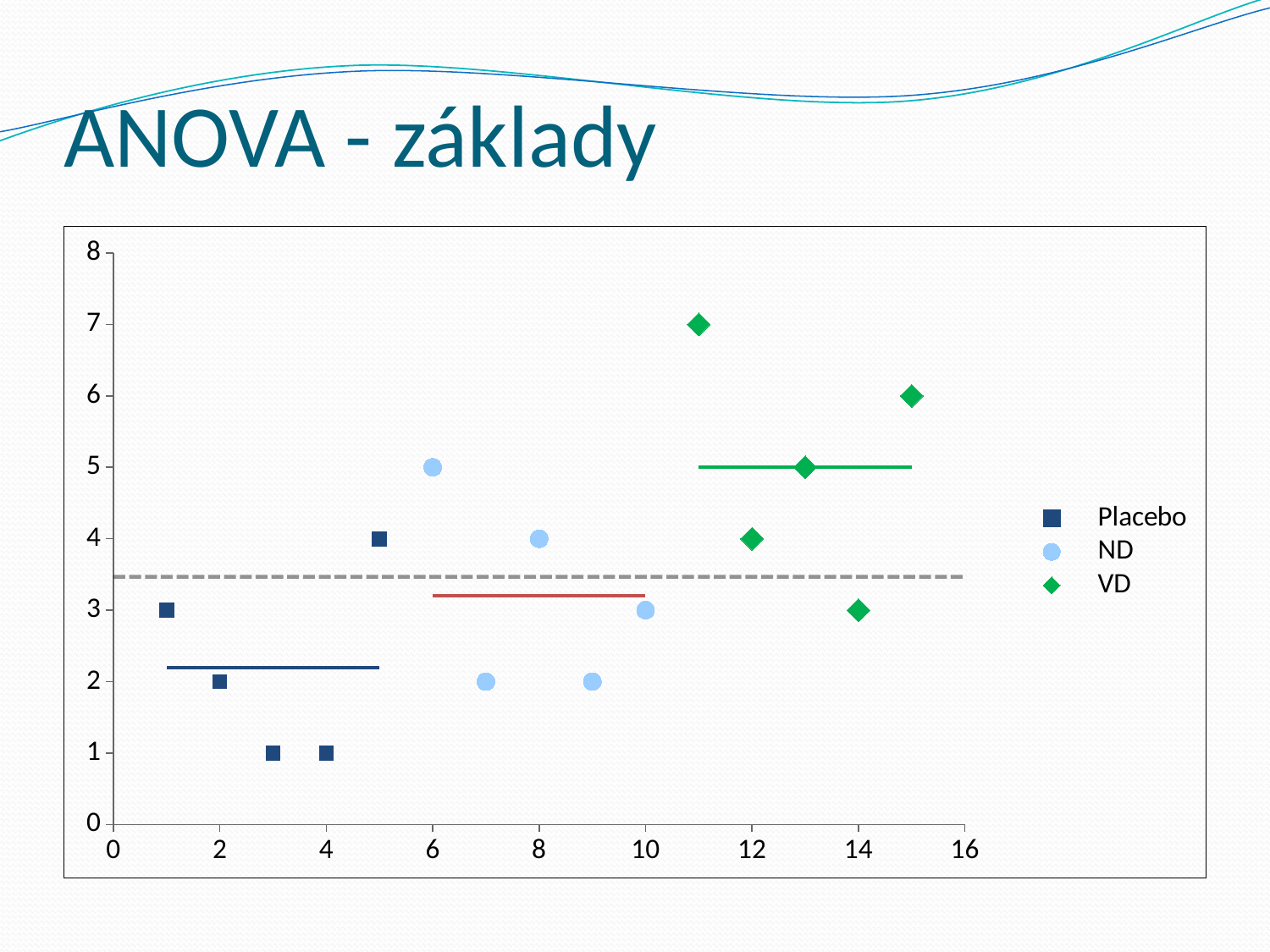
What is the y value of the VD point at x = 11? 7 Which series contains the point with the highest y value? VD What is the y value of the ND point at x = 6? 5 What is the difference between the y value of the VD point at x = 11 and the ND point at x = 10? 4 How many points are plotted for the Placebo series? 5 What is the lowest y value plotted for the Placebo series? 1 How many points are plotted for the VD series? 5 Which series is shown with green diamond markers? VD Which is larger: the y value of the VD point at x = 15 or the ND point at x = 8? VD point at x = 15 What is the y value of the Placebo point at x = 5? 4 What kind of chart is shown on the slide? scatter chart How many series does the legend list? 3